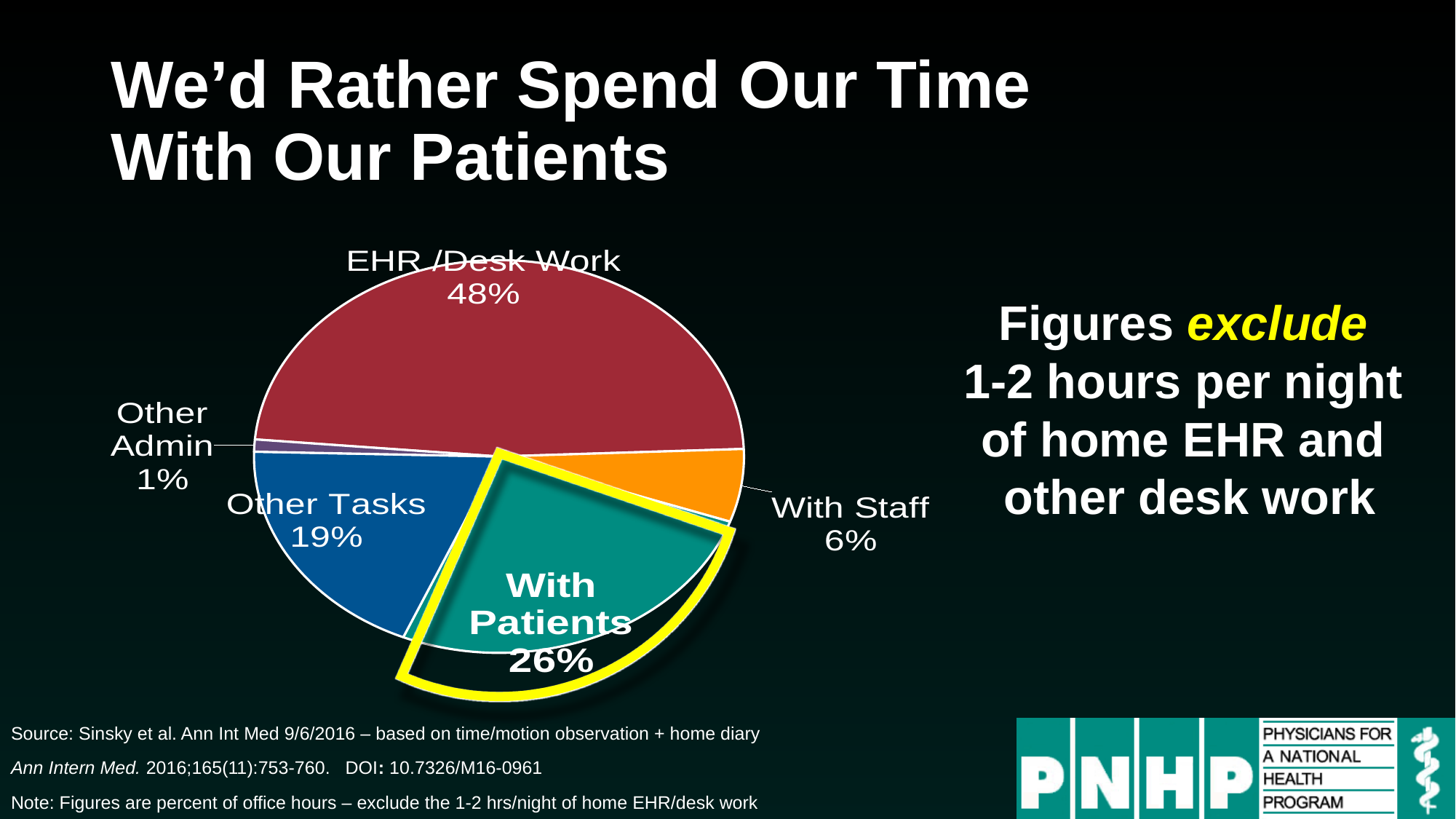
What percentage of office hours is spent on Other Admin? 1% What percentage of office hours is spent on EHR/Desk Work? 48% How many categories does the pie chart show? 5 Which category takes the largest share of office hours? EHR /Desk Work What percentage of office hours is spent With Patients? 26% Which category takes the smallest share of office hours? Other Admin Which slice of the pie chart is pulled out and outlined in yellow? With Patients What percentage of office hours is spent With Staff? 6% What kind of chart is shown on the slide? Pie chart What percentage of office hours is spent on Other Tasks? 19% How many percentage points larger is EHR/Desk Work than With Patients? 22 Which is larger: the share for Other Tasks or the share for With Staff? Other Tasks